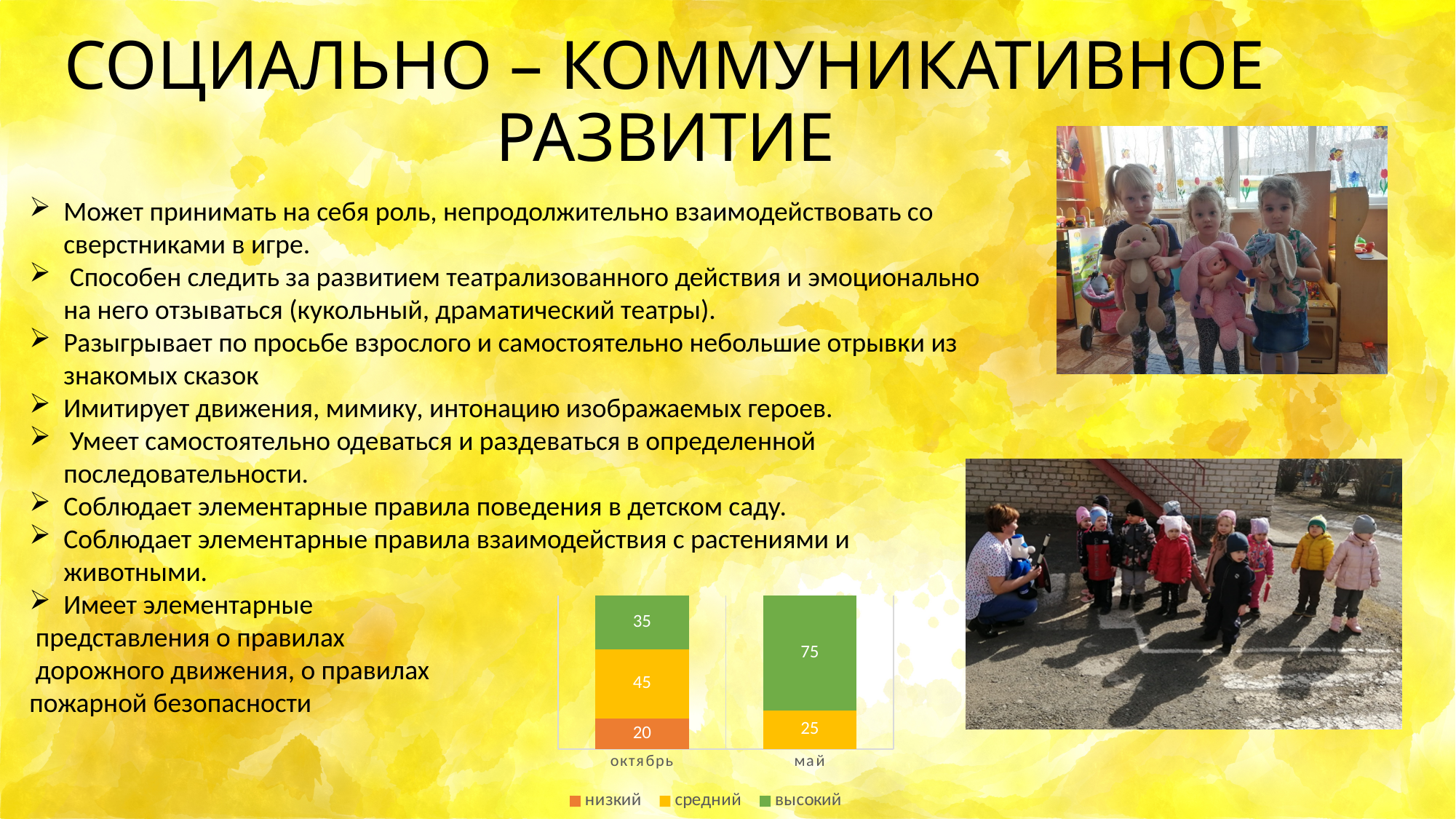
What is the value of средний for октябрь? 45 What is the value of высокий for октябрь? 35 What is the difference between the высокий values for май and октябрь? 40 What is the value of средний for май? 25 Which legend entry is shown in green? высокий What kind of chart is shown on the slide? stacked bar chart What is the total of the stacked bar for октябрь? 100 Which is larger: средний for октябрь or средний for май? октябрь How many series does the chart legend list? 3 What is the value of низкий for октябрь? 20 What is the value of высокий for май? 75 How many categories are shown on the x axis of the chart? 2